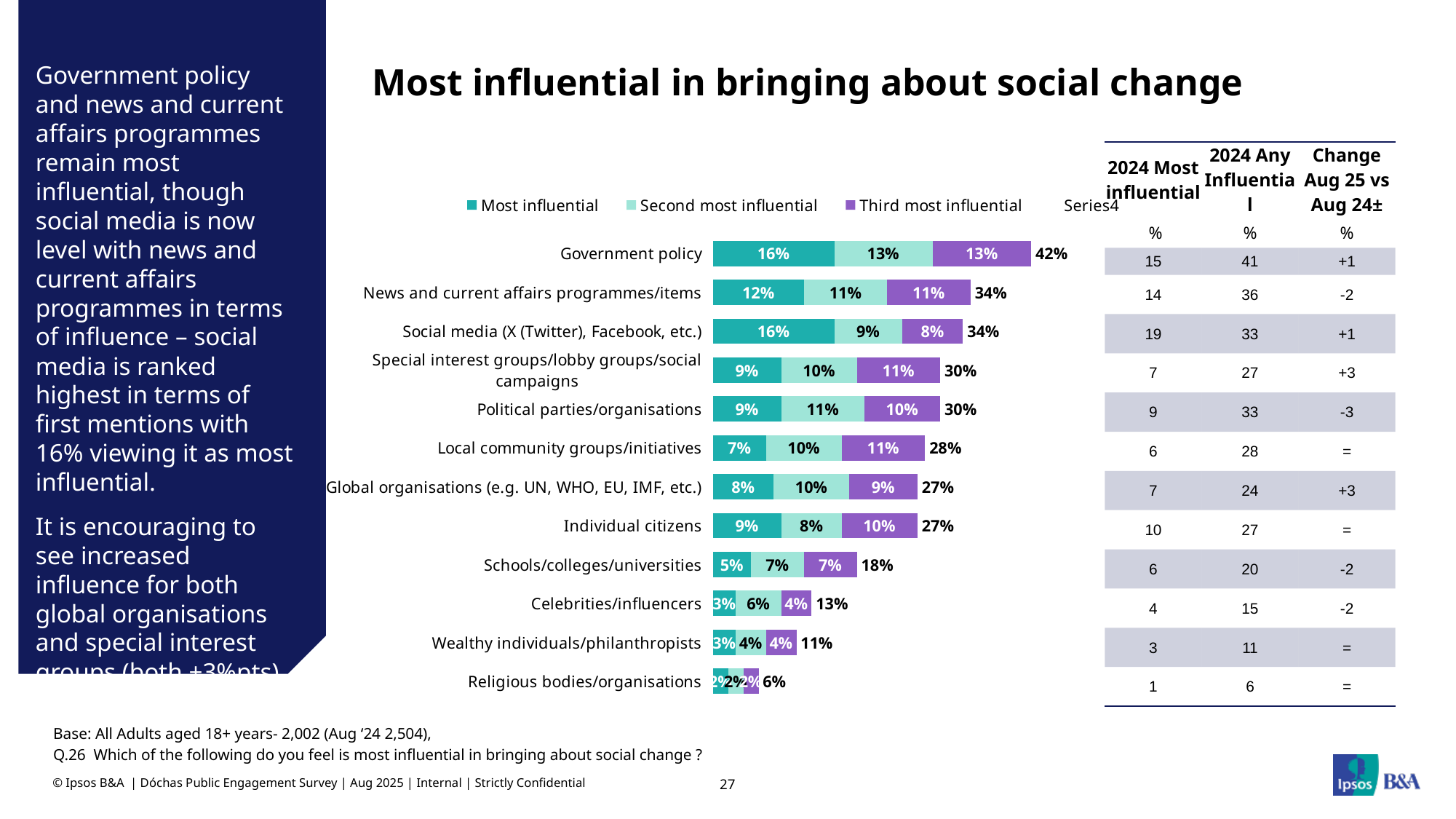
Which has the larger 'Most influential' value: Government policy or News and current affairs programmes/items? Government policy What is the difference between the total for Government policy and the total for News and current affairs programmes/items? 8 percentage points What is the 'Third most influential' value for Local community groups/initiatives? 11% Which category has the lowest total across the three series? Religious bodies/organisations What is the total shown for the Government policy bar? 42% Which category has the highest total across the three series? Government policy What kind of chart is shown on the slide? Stacked bar chart What is the 'Most influential' value for Social media (X (Twitter), Facebook, etc.)? 16% What is the total shown for the Schools/colleges/universities bar? 18% What is the title of the chart? Most influential in bringing about social change What is the 'Second most influential' value for Political parties/organisations? 11% How many categories are plotted in the chart? 12